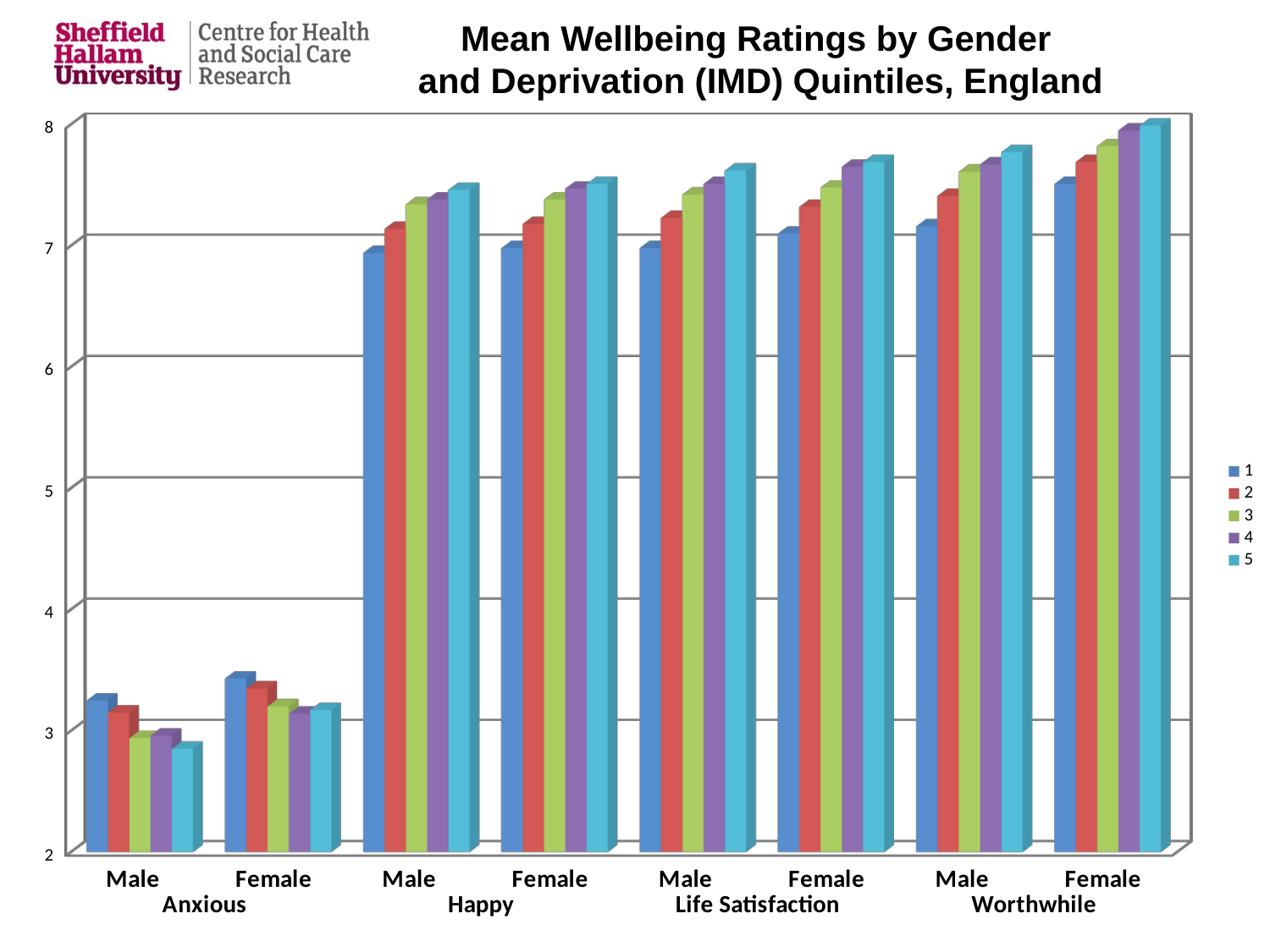
Is the value for series 1 in the Anxious Male group greater or less than 3? greater Which is larger for series 1: the Happy Female value or the Worthwhile Female value? Worthwhile Female Which is larger for series 1: the Anxious Male value or the Anxious Female value? Anxious Female Within the Happy Male group, do the values rise or fall from series 1 to series 5? rise What is the title of the chart? Mean Wellbeing Ratings by Gender and Deprivation (IMD) Quintiles, England Within the Happy Male group, which series has the lowest value? 1 What kind of chart is shown on the slide? bar chart Is the value for series 1 in the Worthwhile Male group greater or less than 7? greater How many series does the legend list? 5 Is the value for series 5 in the Anxious Male group greater or less than 3? less How many Male/Female category groups are shown along the x axis? 8